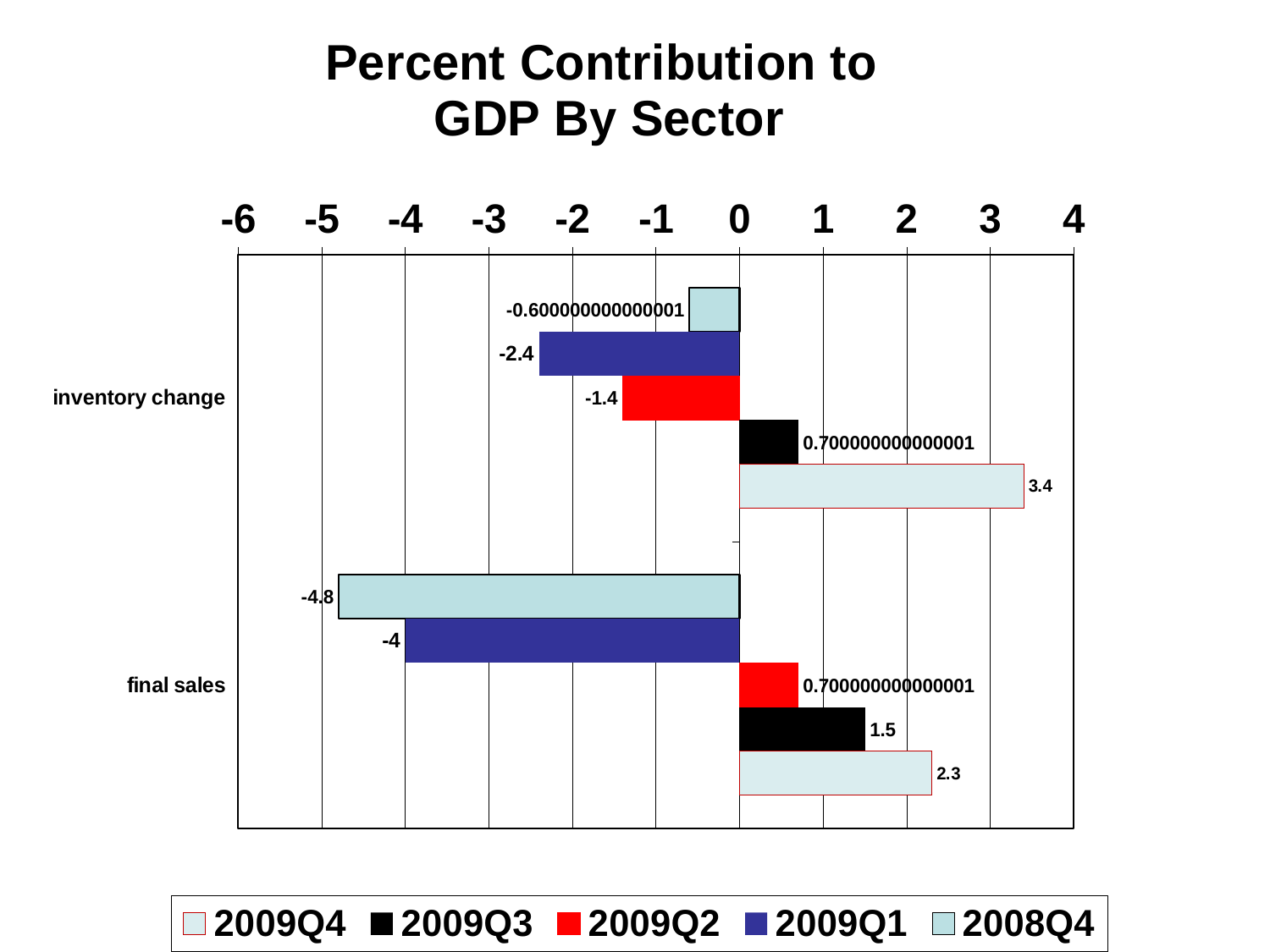
How many series does the legend list? 5 What is the difference between the 2009Q4 value for inventory change and the 2009Q4 value for final sales? 1.1 What type of chart is shown on the slide? Bar chart For final sales, which is larger: the value for 2009Q1 or the value for 2008Q4? 2009Q1 Which quarter has the highest value for final sales? 2009Q4 Which quarter has the lowest value for inventory change? 2009Q1 What is the value for 2008Q4 in the final sales category? -4.8 What is the value for 2009Q3 in the final sales category? 1.5 What is the value for 2009Q1 in the inventory change category? -2.4 What is the value for 2009Q2 in the inventory change category? -1.4 What is the value for 2009Q4 in the inventory change category? 3.4 How many categories are shown on the chart? 2